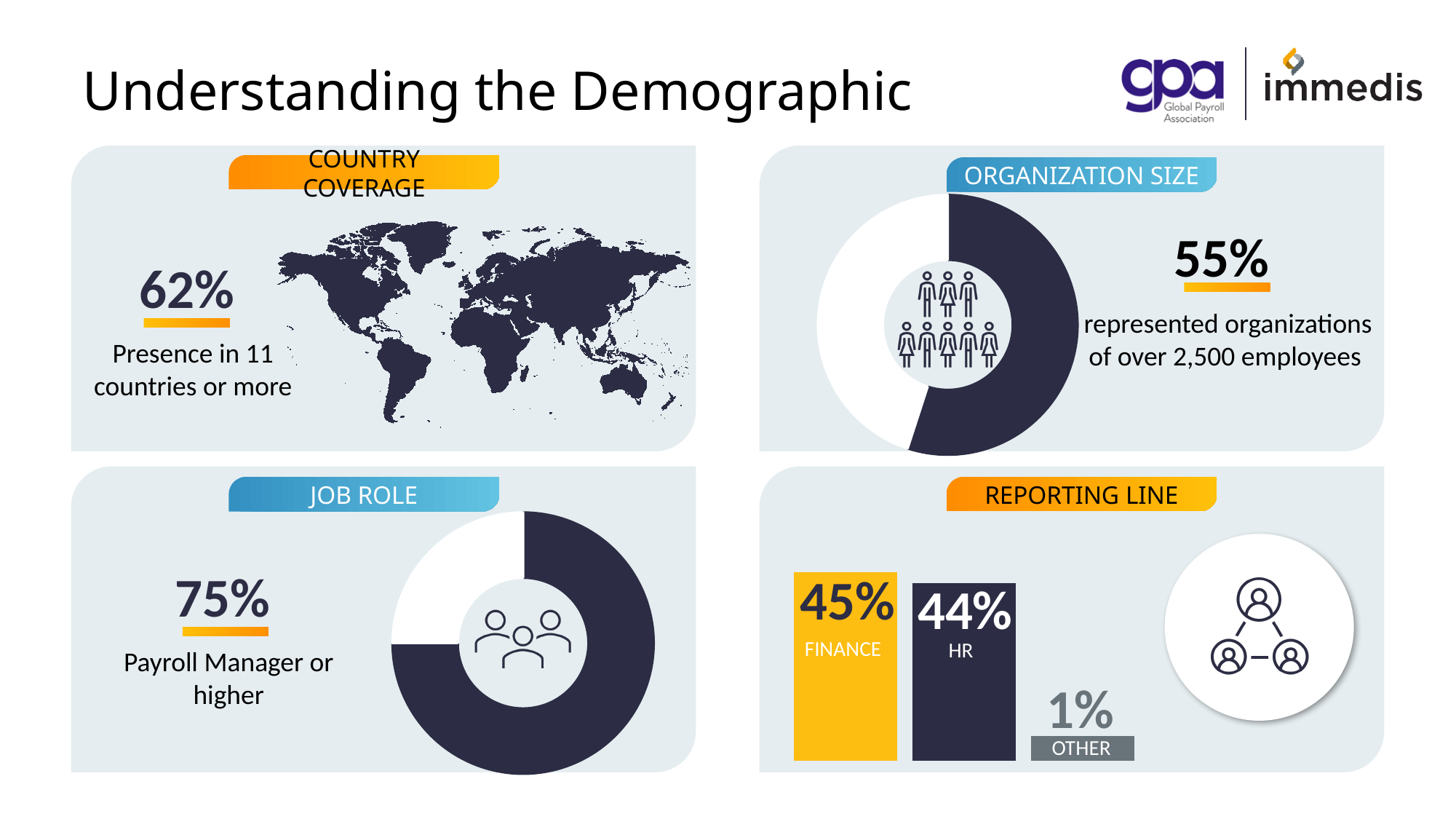
What kind of chart is used in the Reporting Line panel? Bar chart How many categories are shown in the Reporting Line chart? 3 In the Reporting Line chart, which category has the lowest value? Other In the Reporting Line chart, what percentage is shown for HR? 44% In the Reporting Line chart, what is the difference between the Finance and HR values? 1% In the Reporting Line chart, what percentage is shown for Other? 1% In the Organization Size donut chart, what percentage represented organizations of over 2,500 employees? 55% In the Reporting Line chart, what percentage is shown for Finance? 45% In the Reporting Line chart, which is larger, Finance or HR? Finance In the Reporting Line chart, which category has the highest value? Finance What kind of chart is used in the Job Role panel? Donut chart In the Job Role donut chart, what percentage were Payroll Manager or higher? 75%